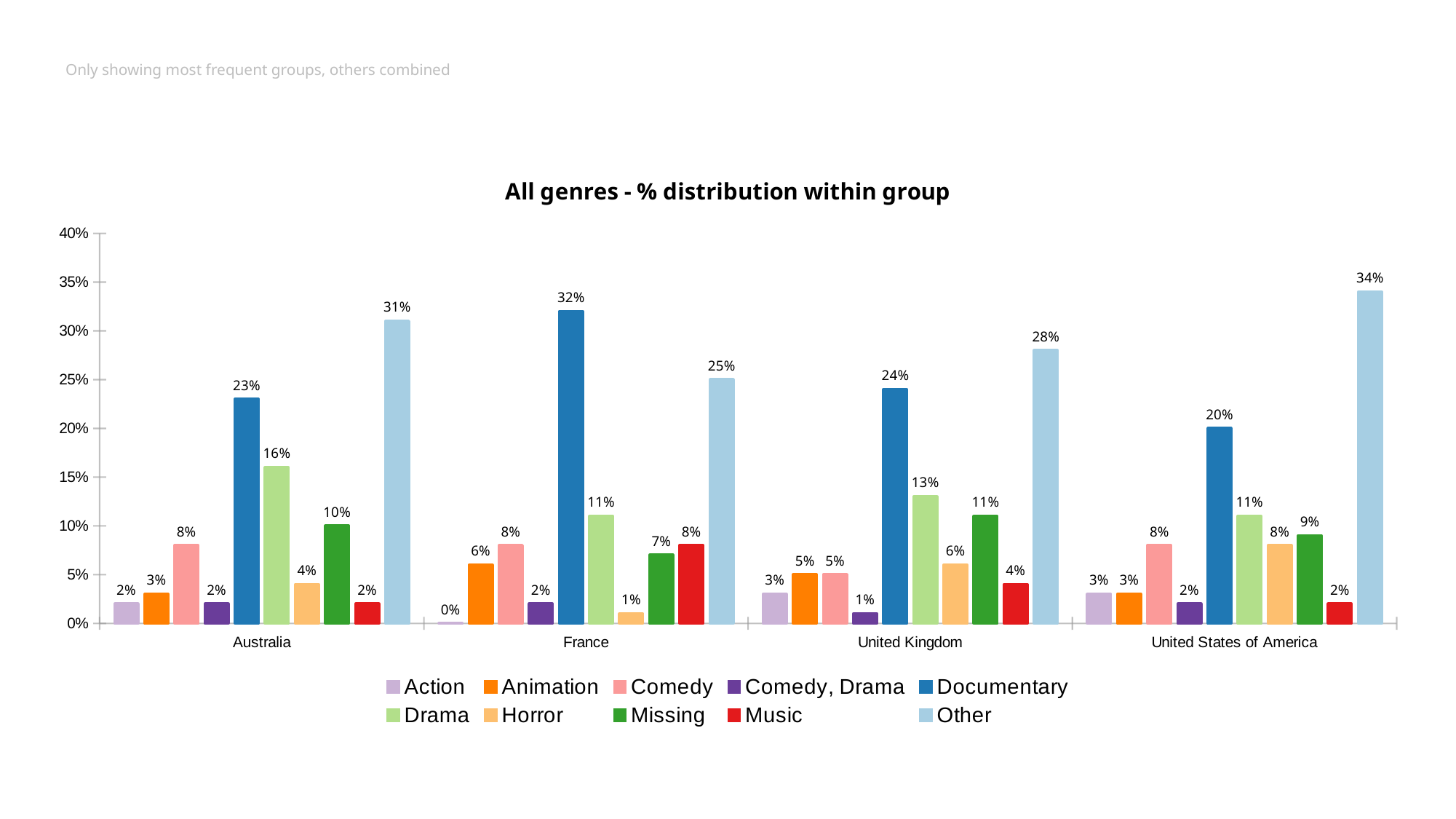
Which country has the highest Documentary value? France What is the Documentary value for France? 32% How many series does the legend list? 10 What is the Other value for the United States of America? 34% What is the difference between the Other value for the United States of America and the Other value for Australia? 3% What is the Missing value for the United Kingdom? 11% What is the Drama value for Australia? 16% Which country has the lowest Other value? France What is the title of the chart? All genres - % distribution within group Which is larger: the Drama value for Australia or the Drama value for the United Kingdom? Australia How many countries are shown on the x axis? 4 What kind of chart is shown on the slide? Bar chart